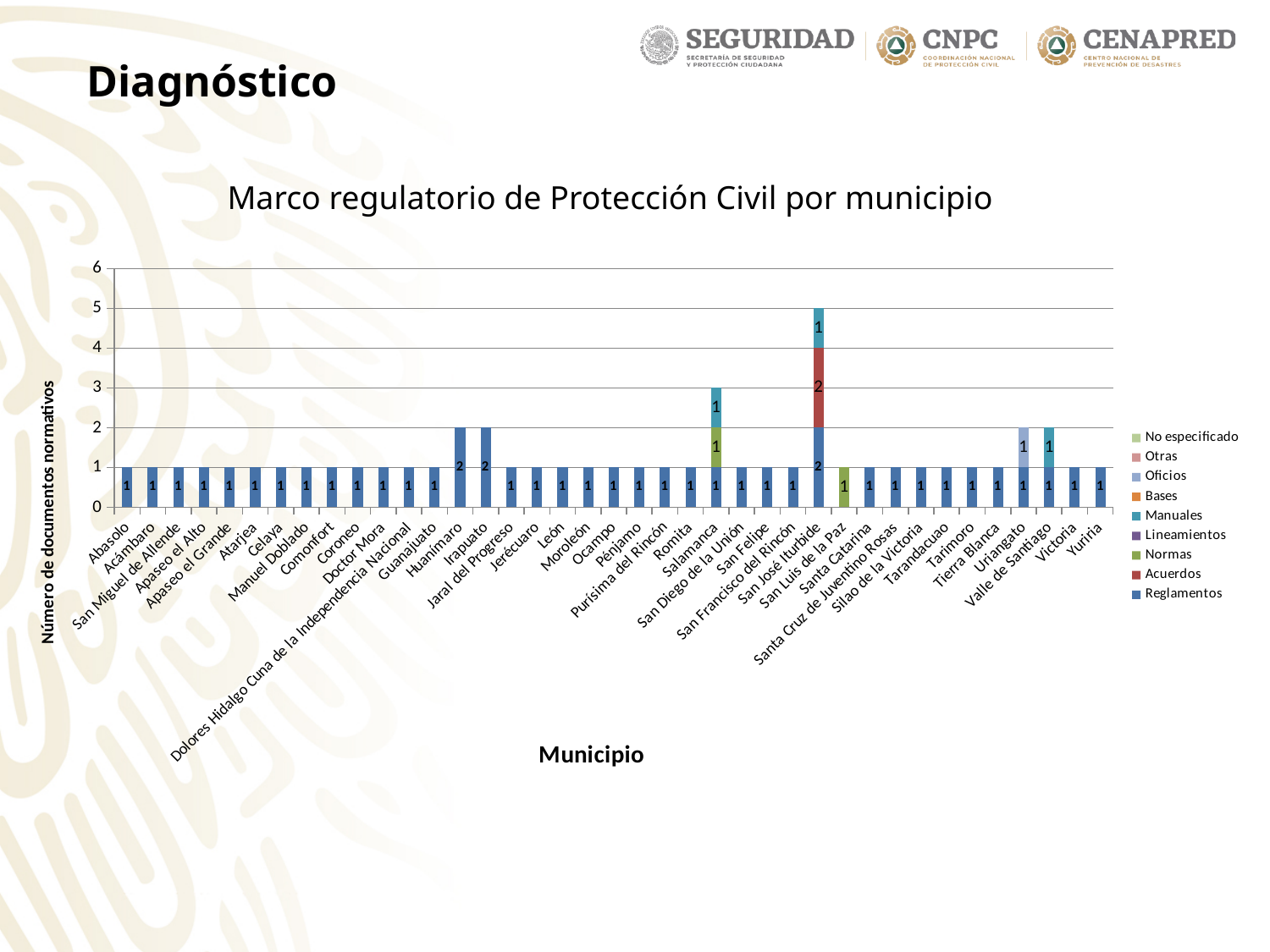
How many series does the legend list? 9 Which municipio has a taller stacked bar, Salamanca or Irapuato? Salamanca What kind of chart is used to show the 'Marco regulatorio de Protección Civil por municipio'? Stacked bar chart What is the total height of the stacked bar for Salamanca? 3 What is the difference between the total for San José Iturbide and the total for Salamanca? 2 What is the value of Reglamentos for Huanímaro? 2 What is the value of Acuerdos for San José Iturbide? 2 Which municipio has the tallest stacked bar in the chart? San José Iturbide What is the total height of the stacked bar for San José Iturbide? 5 What is the title of the vertical axis? Número de documentos normativos What is the value of Normas for San Luis de la Paz? 1 What is the value of Oficios for Uriangato? 1